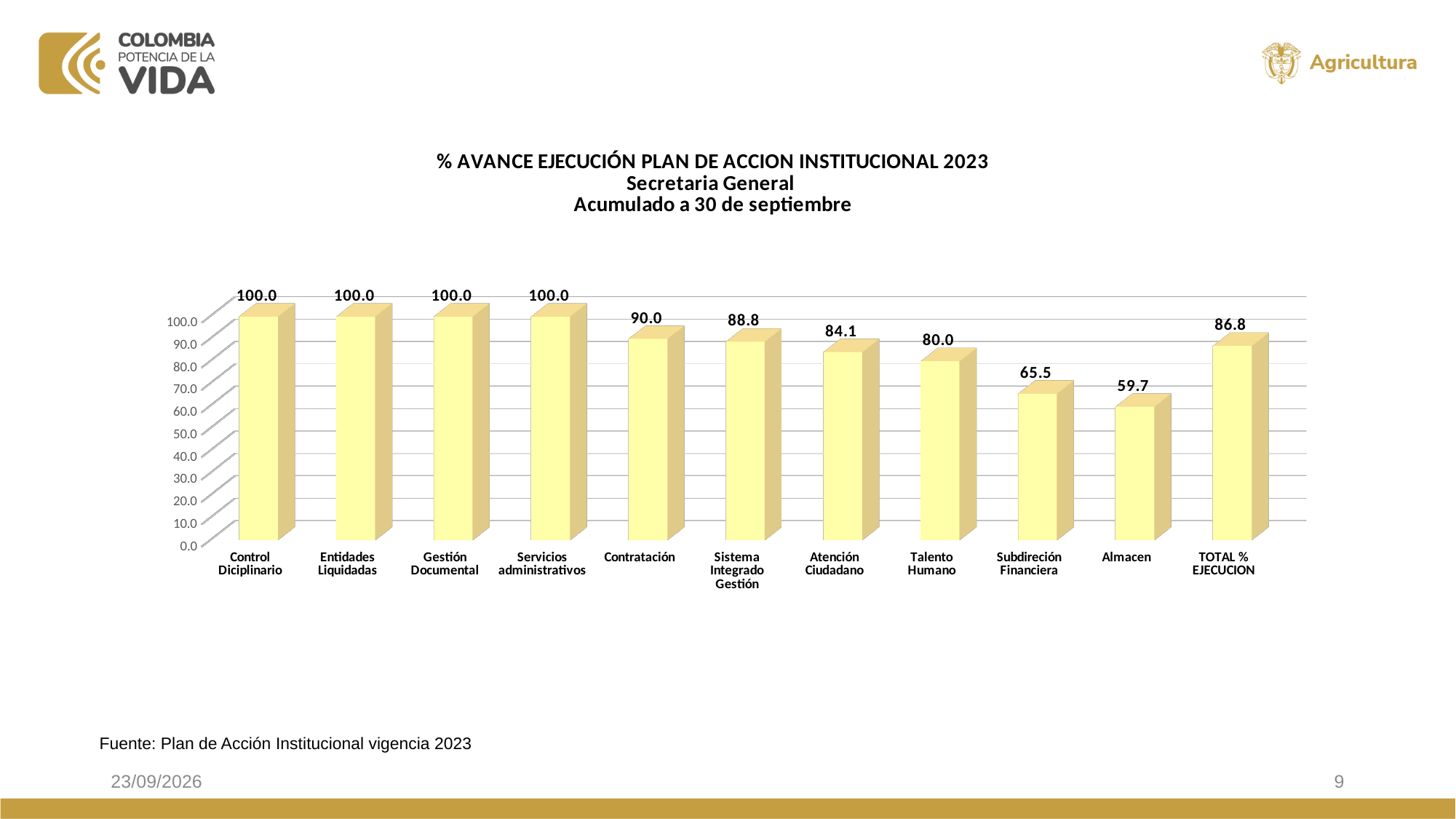
What is the value for Almacen? 59.7 How many categories are shown on the x axis? 11 What is the value for Contratación? 90.0 What is the difference between the values for Contratación and Sistema Integrado Gestión? 1.2 How many categories have a value of 100.0? 4 What is the difference between the values for Atención Ciudadano and Talento Humano? 4.1 What is the title of the chart? % AVANCE EJECUCIÓN PLAN DE ACCION INSTITUCIONAL 2023 Secretaria General Acumulado a 30 de septiembre What is the value for TOTAL % EJECUCION? 86.8 What kind of chart is shown on the slide? Bar chart What is the value for Subdireción Financiera? 65.5 Which category has the lowest value? Almacen Which is larger, the value for Talento Humano or the value for Subdireción Financiera? Talento Humano